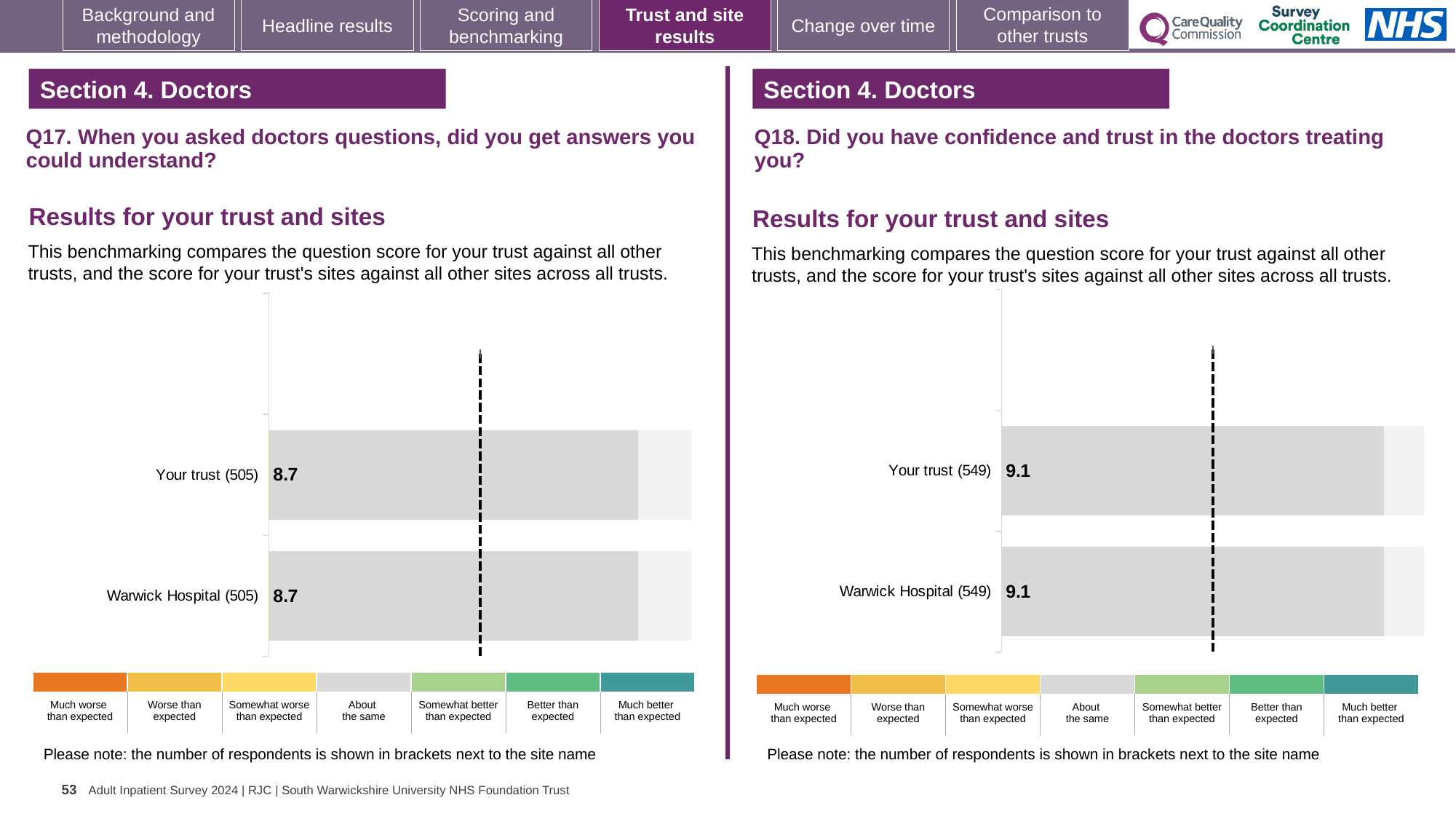
How many bars are plotted on the Q17 chart (left)? 2 On the Q17 chart (left), how many respondents are shown in brackets for Your trust? 505 On the Q17 chart (left), what is the score for Your trust? 8.7 On the Q17 chart (left), what is the score for Warwick Hospital? 8.7 What kind of chart is shown for Q17 (left)? Bar chart On the Q18 chart (right), what is the score for Warwick Hospital? 9.1 On the Q18 chart (right), what is the difference between the scores for Your trust and Warwick Hospital? 0 On the Q18 chart (right), what is the score for Your trust? 9.1 How many bars are plotted on the Q18 chart (right)? 2 On the Q18 chart (right), how many respondents are shown in brackets for Warwick Hospital? 549 On the Q17 chart (left), what is the difference between the scores for Your trust and Warwick Hospital? 0 Is the score for Your trust on the Q18 chart (right) larger or smaller than the score for Your trust on the Q17 chart (left)? Larger